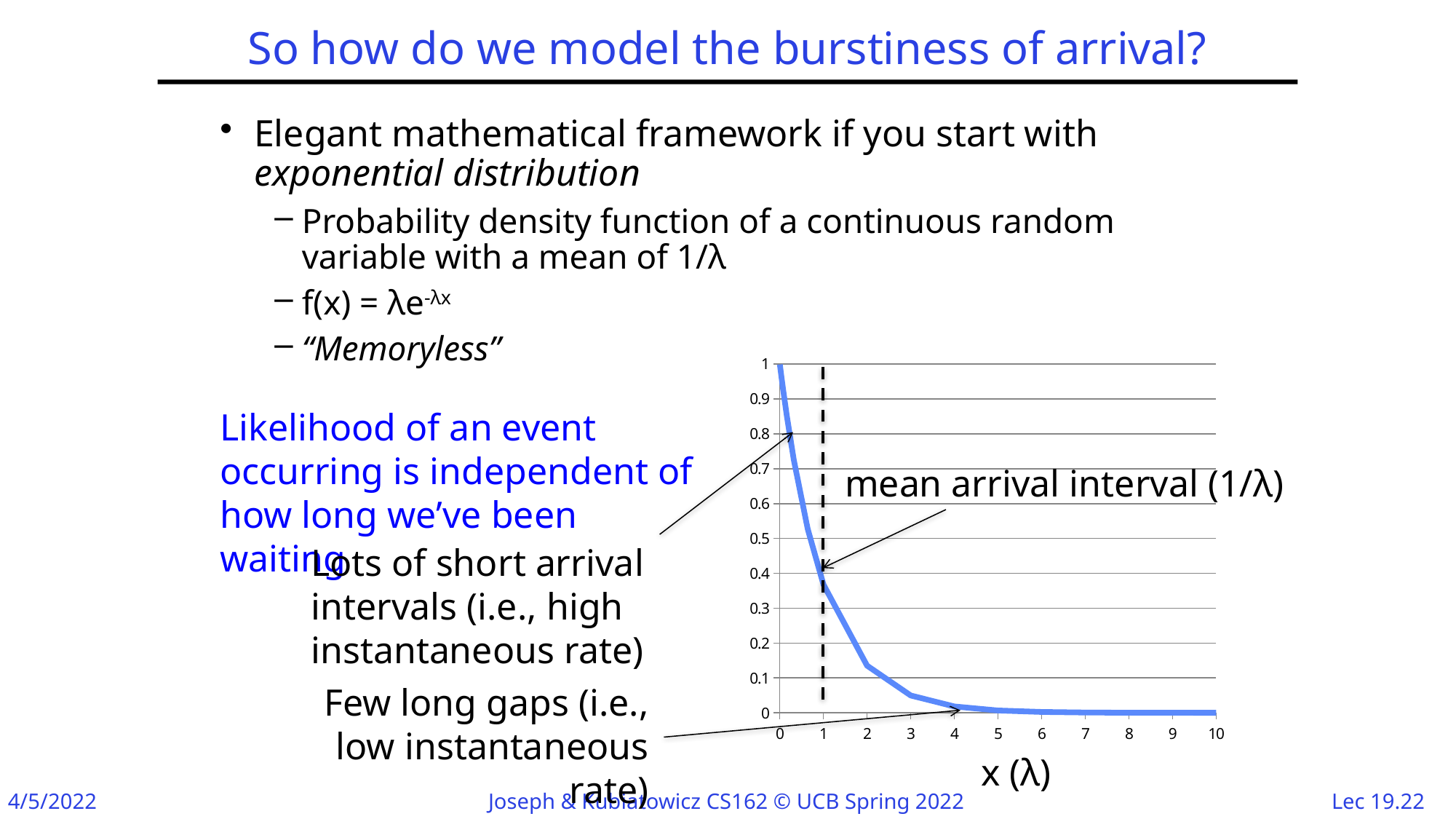
What is the largest value shown on the x axis? 10 At which x value does the curve reach its highest point? 0 Is the value of the curve at x = 4 greater or less than 0.1? less What is the highest value shown on the y axis? 1 Is the value of the curve at x = 1 greater or less than 0.5? less Is the value of the curve at x = 2 greater or less than 0.2? less What is the label of the x axis of the chart? x (λ) Do the plotted values rise or fall as x increases along the x axis? fall Which is larger, the value of the curve at x = 1 or at x = 3? x = 1 At which x value is the dashed vertical line labelled 'mean arrival interval (1/λ)' drawn? 1 What kind of chart is shown on the slide? line chart